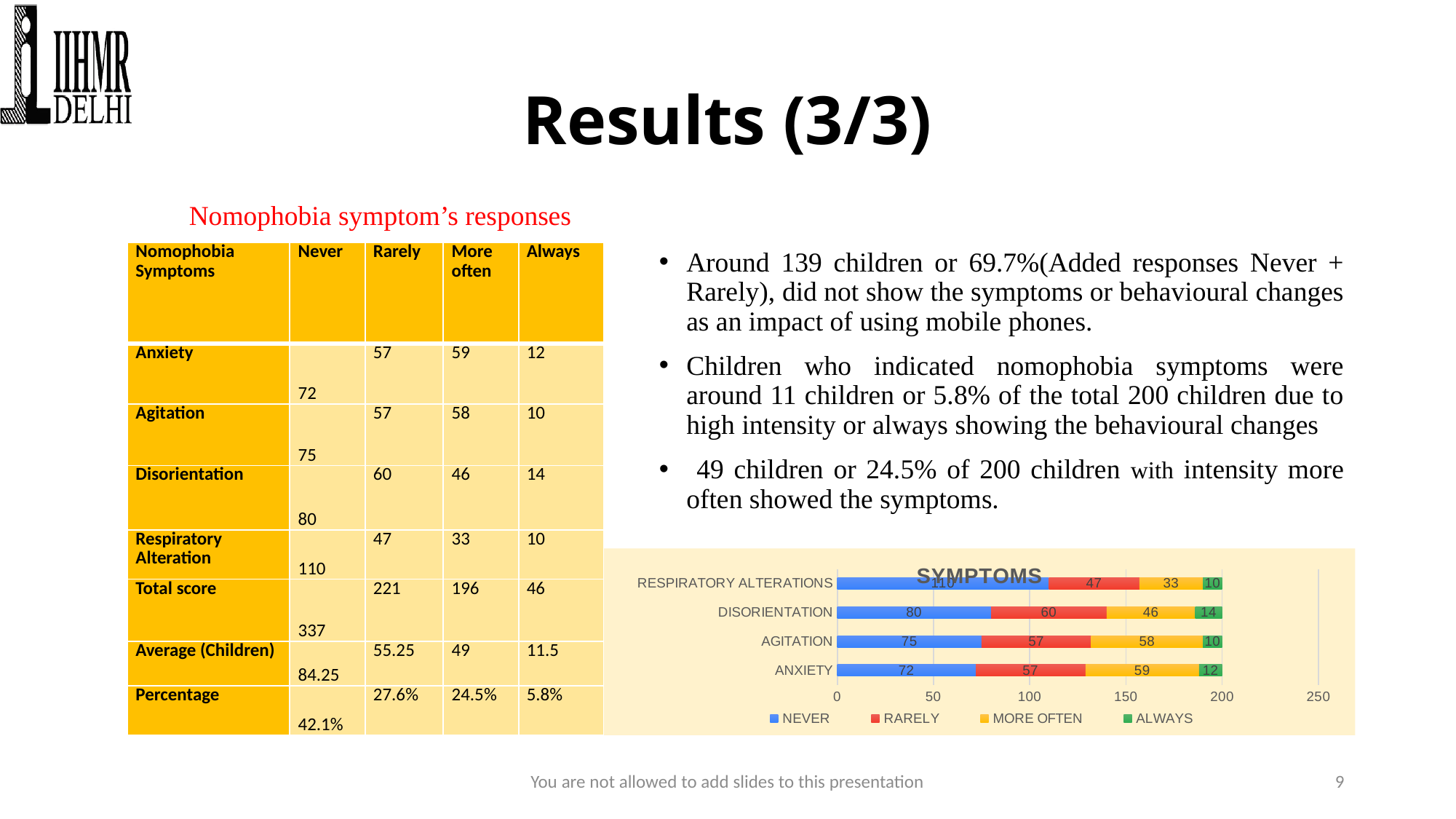
In the SYMPTOMS chart, which is larger: the RARELY value for DISORIENTATION or the RARELY value for AGITATION? DISORIENTATION In the SYMPTOMS chart, what is the NEVER value for RESPIRATORY ALTERATIONS? 110 In the SYMPTOMS chart, what is the difference between the NEVER values for RESPIRATORY ALTERATIONS and ANXIETY? 38 In the SYMPTOMS chart, which symptom has the lowest MORE OFTEN value? RESPIRATORY ALTERATIONS How many series does the legend of the SYMPTOMS chart list? 4 What kind of chart is the SYMPTOMS chart? Stacked bar chart In the SYMPTOMS chart, what is the total of the stacked bar for ANXIETY? 200 In the SYMPTOMS chart, what is the MORE OFTEN value for AGITATION? 58 In the SYMPTOMS chart, what is the ALWAYS value for DISORIENTATION? 14 In the SYMPTOMS chart, which symptom has the highest NEVER value? RESPIRATORY ALTERATIONS How many symptom categories are plotted in the SYMPTOMS chart? 4 Which colour represents the ALWAYS series in the SYMPTOMS chart? Green